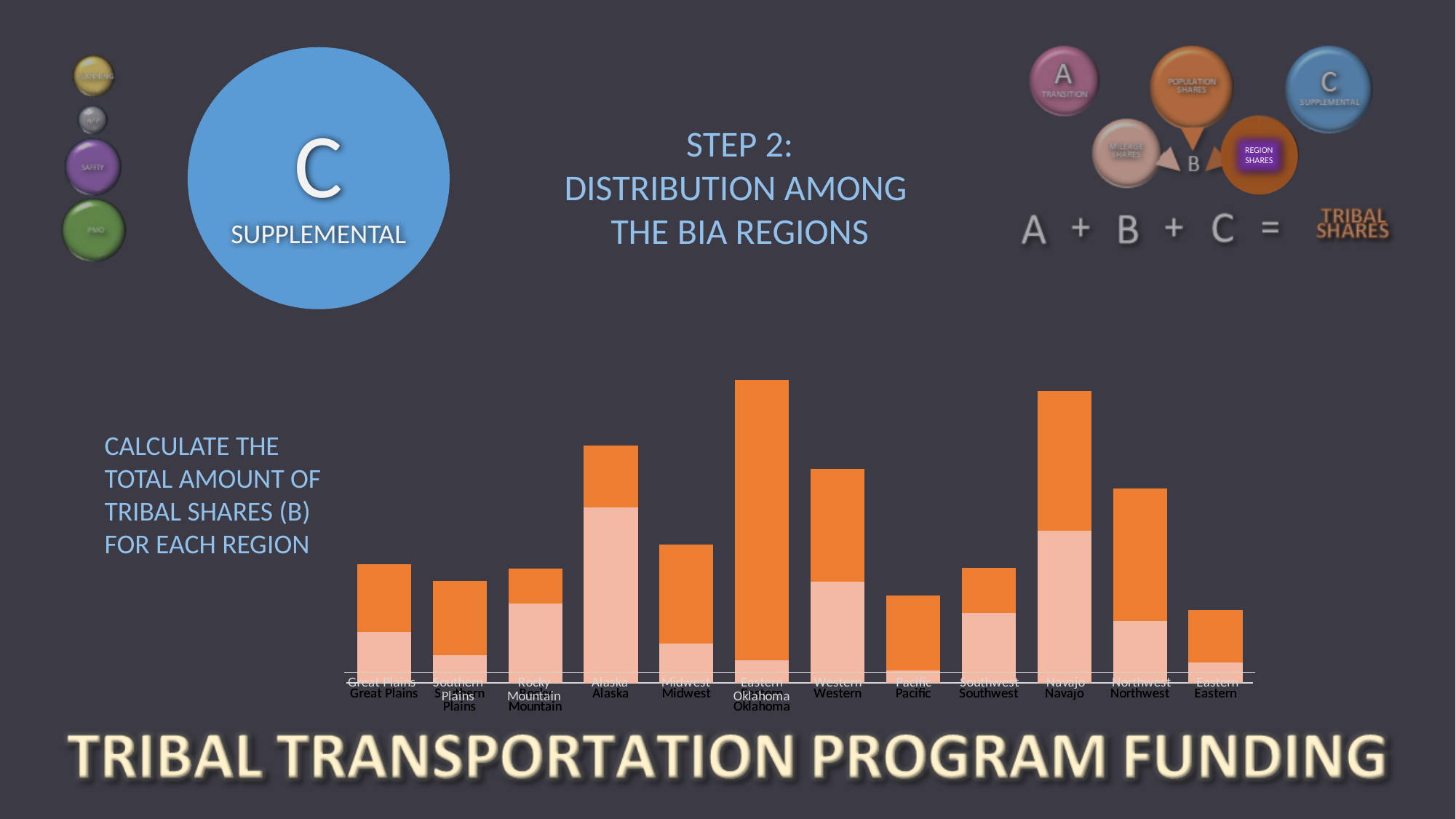
What kind of chart is shown on the slide? stacked bar chart What is the first region listed on the left of the x axis? Great Plains Which bar is taller, Great Plains or Southern Plains? Great Plains Which region has the largest light-coloured (bottom) segment in its bar? Alaska How many regions (categories) are shown on the bar chart? 12 Which region has the largest dark orange (top) segment in its bar? Eastern Oklahoma Which region has the shortest stacked bar in the chart? Eastern Which region has the second tallest stacked bar? Navajo What instruction text appears to the left of the chart? CALCULATE THE TOTAL AMOUNT OF TRIBAL SHARES (B) FOR EACH REGION Which region has the tallest stacked bar in the chart? Eastern Oklahoma